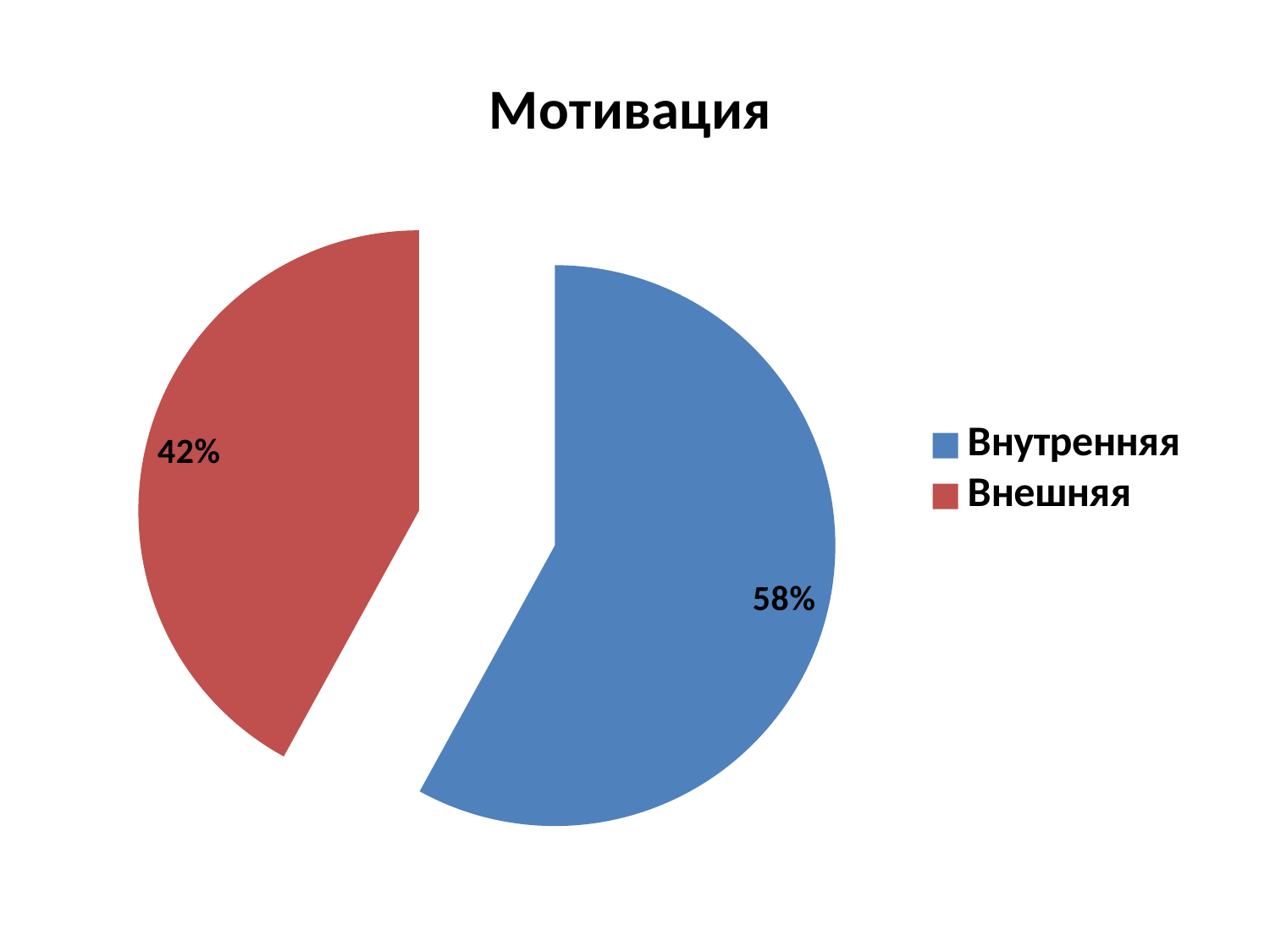
How many entries does the legend list? 2 What is the title of the chart? Мотивация Which category has the largest slice? Внутренняя What kind of chart is shown on the slide? pie chart Which is larger, Внутренняя or Внешняя? Внутренняя Which category has the smallest slice? Внешняя What colour is the Внешняя slice? red What share of the pie does Внешняя have? 42% Is the value for Внутренняя greater or less than 50%? greater What is the difference in percentage points between Внутренняя and Внешняя? 16% How many slices does the pie chart have? 2 What share of the pie does Внутренняя have? 58%